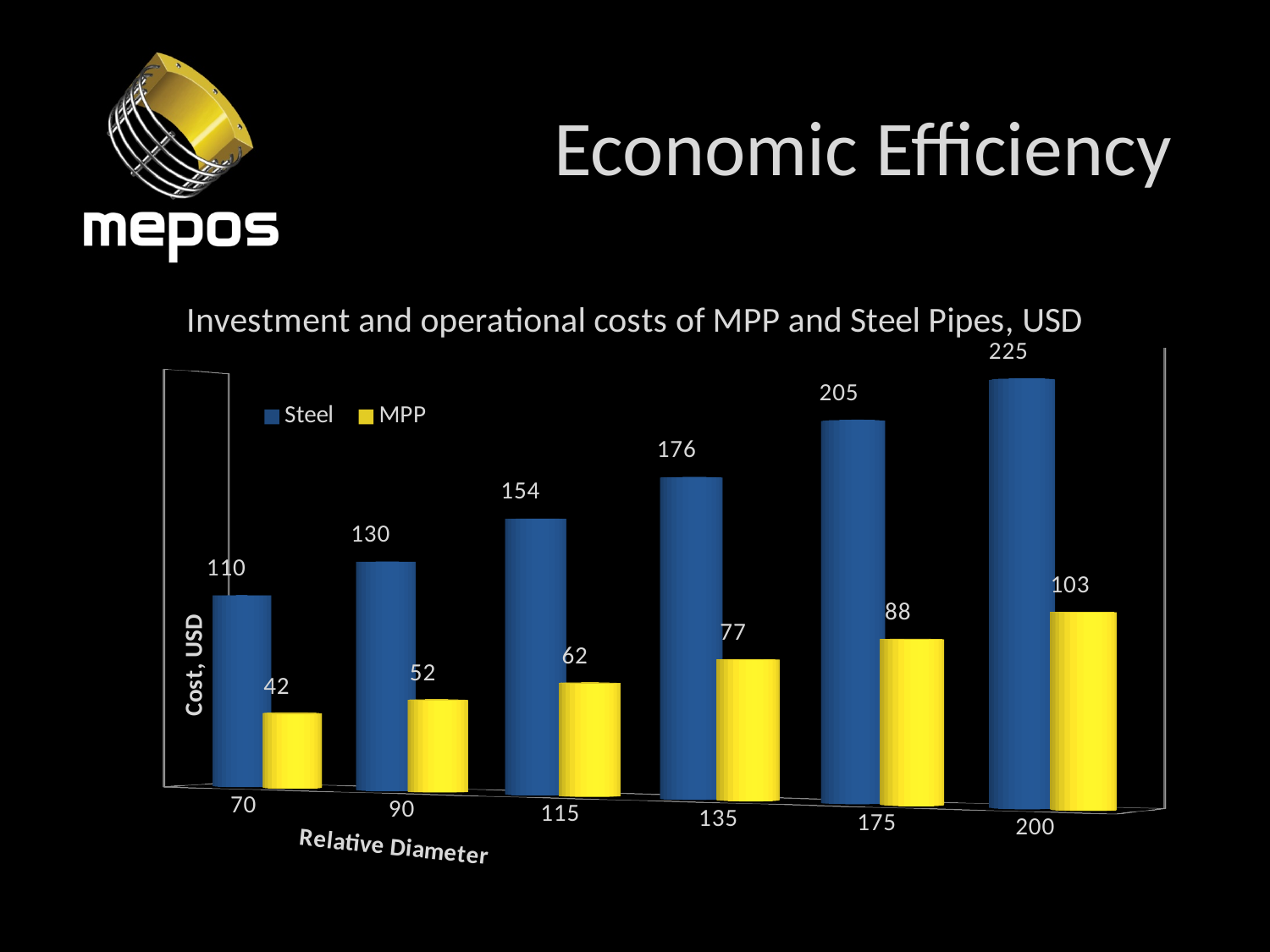
What is the MPP cost at relative diameter 70? 42 What is the MPP cost at relative diameter 175? 88 Do the MPP costs rise or fall as relative diameter increases? Rise At which relative diameter is the MPP cost lowest? 70 How many series does the legend list? 2 How many relative diameter categories are shown on the x axis? 6 At which relative diameter is the Steel cost highest? 200 What is the difference between the Steel and MPP costs at relative diameter 200? 122 What is the difference between the Steel costs at relative diameter 135 and 90? 46 Which is larger, the Steel cost at relative diameter 70 or the MPP cost at relative diameter 200? Steel cost at relative diameter 70 What is the Steel cost at relative diameter 115? 154 What kind of chart is shown on the slide? Bar chart